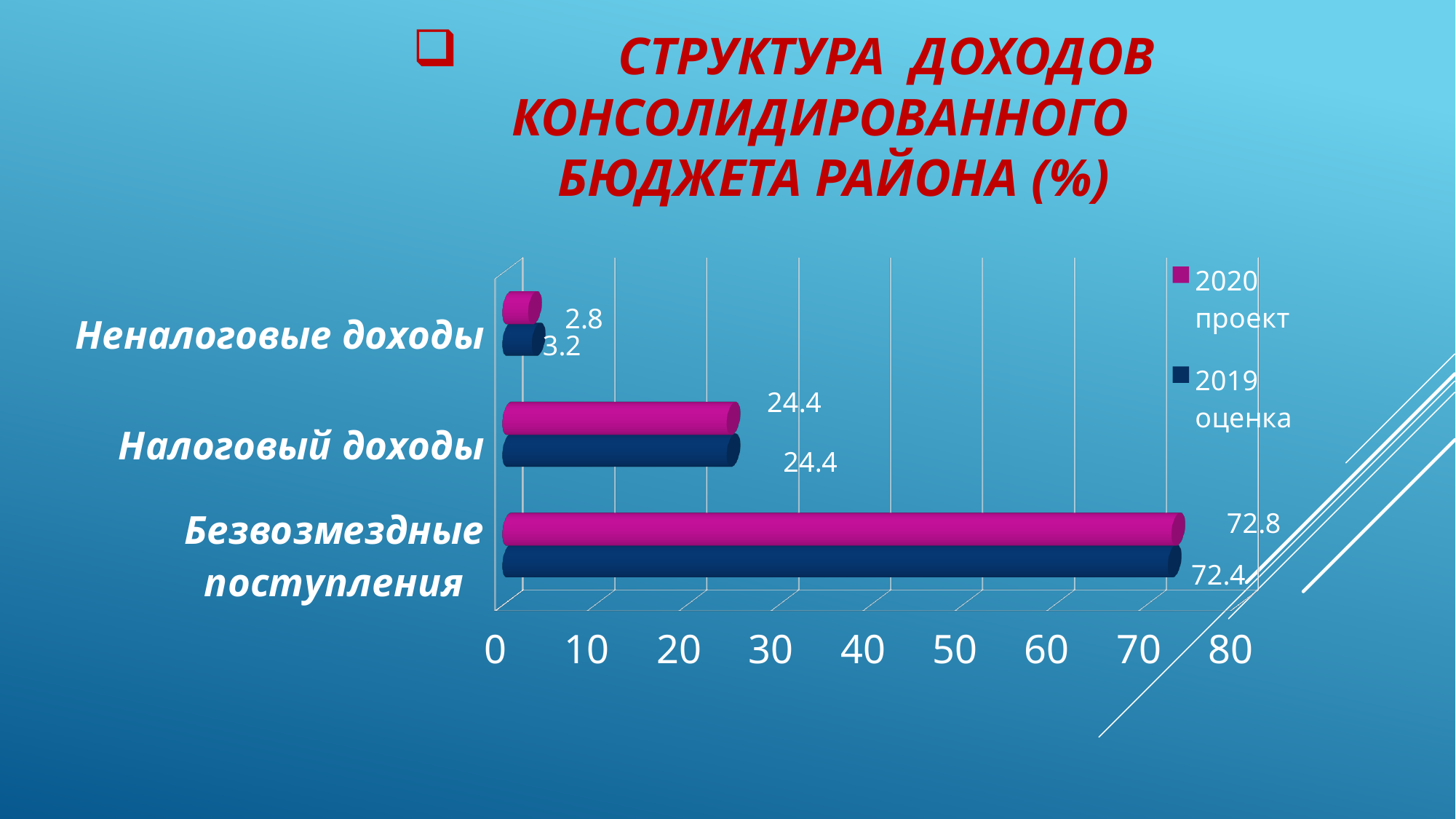
What is the value for Налоговый доходы in the 2020 проект series? 24.4 How many series does the legend list? 2 What is the value for Неналоговые доходы in the 2019 оценка series? 3.2 How many categories are shown on the chart? 3 Which category has the highest value in the 2019 оценка series? Безвозмездные поступления Which category has the lowest value in the 2020 проект series? Неналоговые доходы Is the 2020 проект value for Безвозмездные поступления greater or less than 70? greater What is the difference between the 2020 проект and 2019 оценка values for Безвозмездные поступления? 0.4 What is the value for Безвозмездные поступления in the 2020 проект series? 72.8 What kind of chart is shown on the slide? bar chart For Неналоговые доходы, which series has the larger value: 2020 проект or 2019 оценка? 2019 оценка Which series is shown in magenta according to the legend? 2020 проект